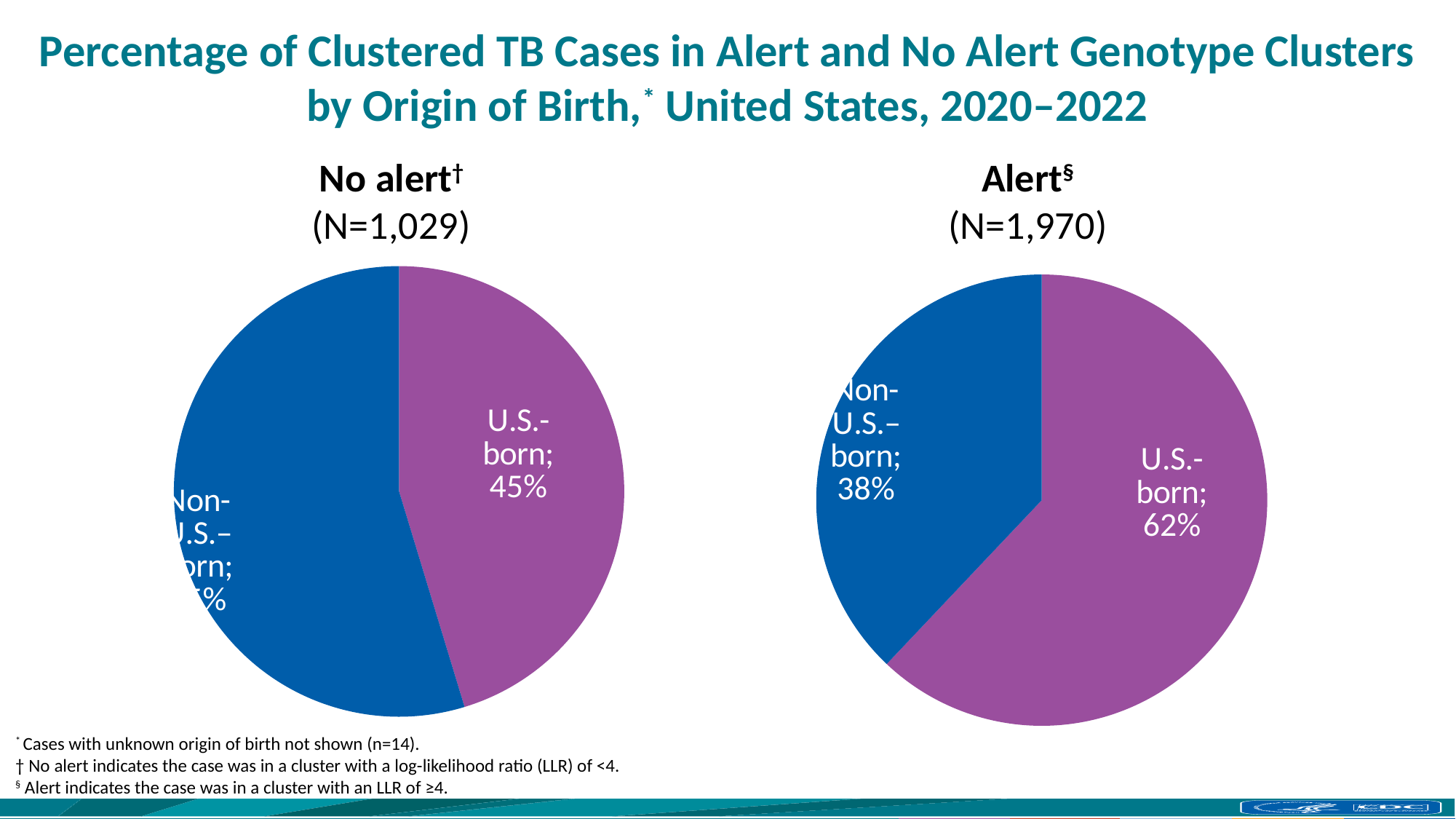
What is the N shown for the Alert pie chart? N=1,970 Which pie chart shows a larger U.S.-born share, No alert or Alert? Alert What is the N shown for the No alert pie chart? N=1,029 What type of chart is used on this slide? Pie chart In the Alert pie chart, what is the difference in percentage points between the U.S.-born and Non-U.S.-born shares? 24 In the Alert pie chart, which origin of birth has the larger share? U.S.-born In the No alert pie chart, what percentage of clustered TB cases were U.S.-born? 45% In the Alert pie chart, what percentage of clustered TB cases were Non-U.S.-born? 38% In the No alert pie chart, which slice is larger: U.S.-born or Non-U.S.-born? Non-U.S.-born In the Alert pie chart, what percentage of clustered TB cases were U.S.-born? 62% In the Alert pie chart, which origin of birth has the smaller share? Non-U.S.-born How many slices does the Alert pie chart have? 2